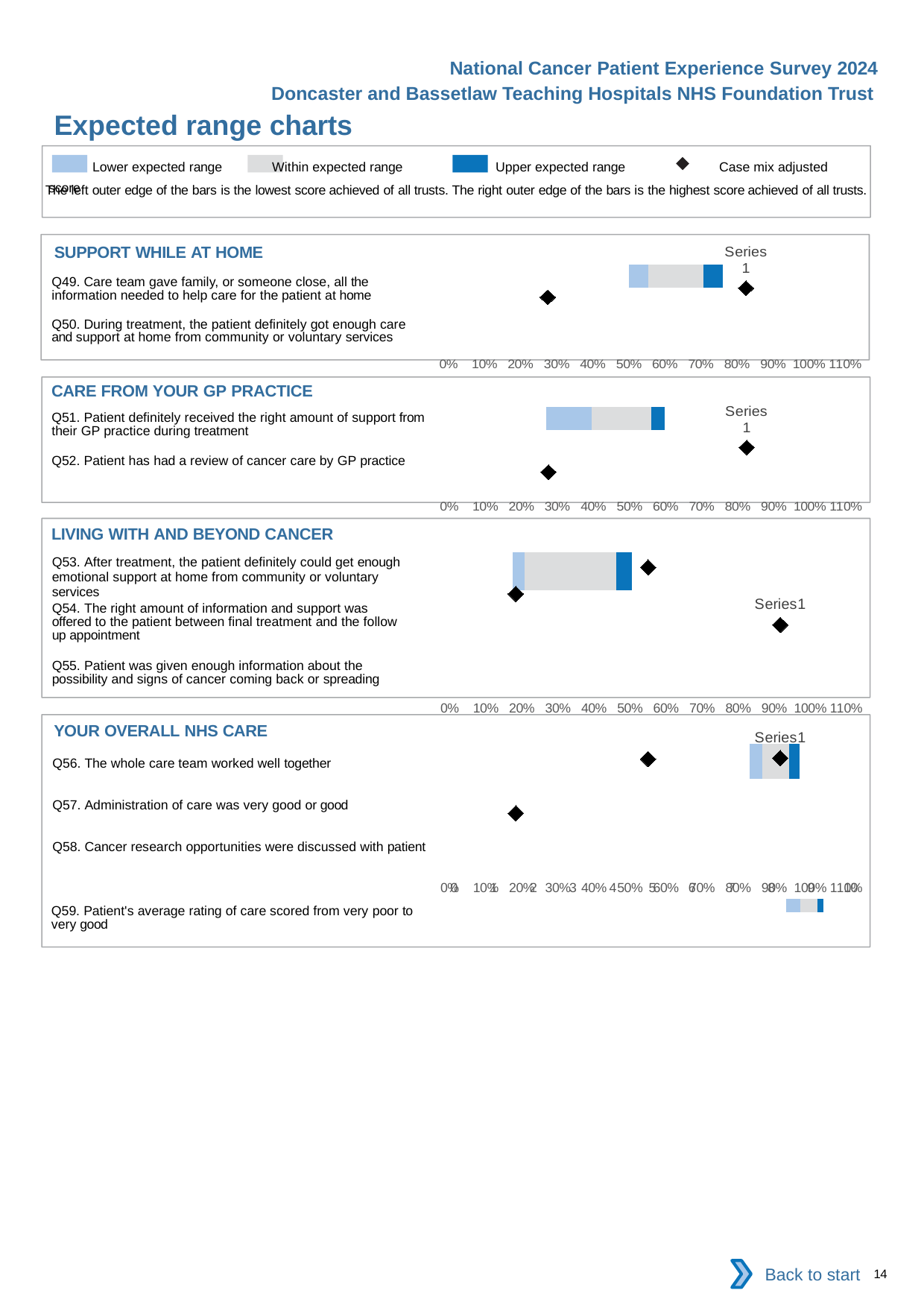
What is the highest percentage tick shown on the x axis of the CARE FROM YOUR GP PRACTICE chart? 110% How many entries does the legend at the top of the slide list? 4 How many questions are listed in the CARE FROM YOUR GP PRACTICE section? 2 In the SUPPORT WHILE AT HOME chart, is the diamond marker plotted furthest to the left greater or less than 50%? less What does the legend say the diamond marker represents? Case mix adjusted score In the CARE FROM YOUR GP PRACTICE chart, is the diamond marker plotted furthest to the left greater or less than 50%? less How many questions are listed in the SUPPORT WHILE AT HOME section? 2 How many questions are listed in the YOUR OVERALL NHS CARE section? 4 In the YOUR OVERALL NHS CARE chart, is the diamond marker plotted furthest to the left greater or less than 40%? less What kind of chart is used in the SUPPORT WHILE AT HOME section? Bar chart